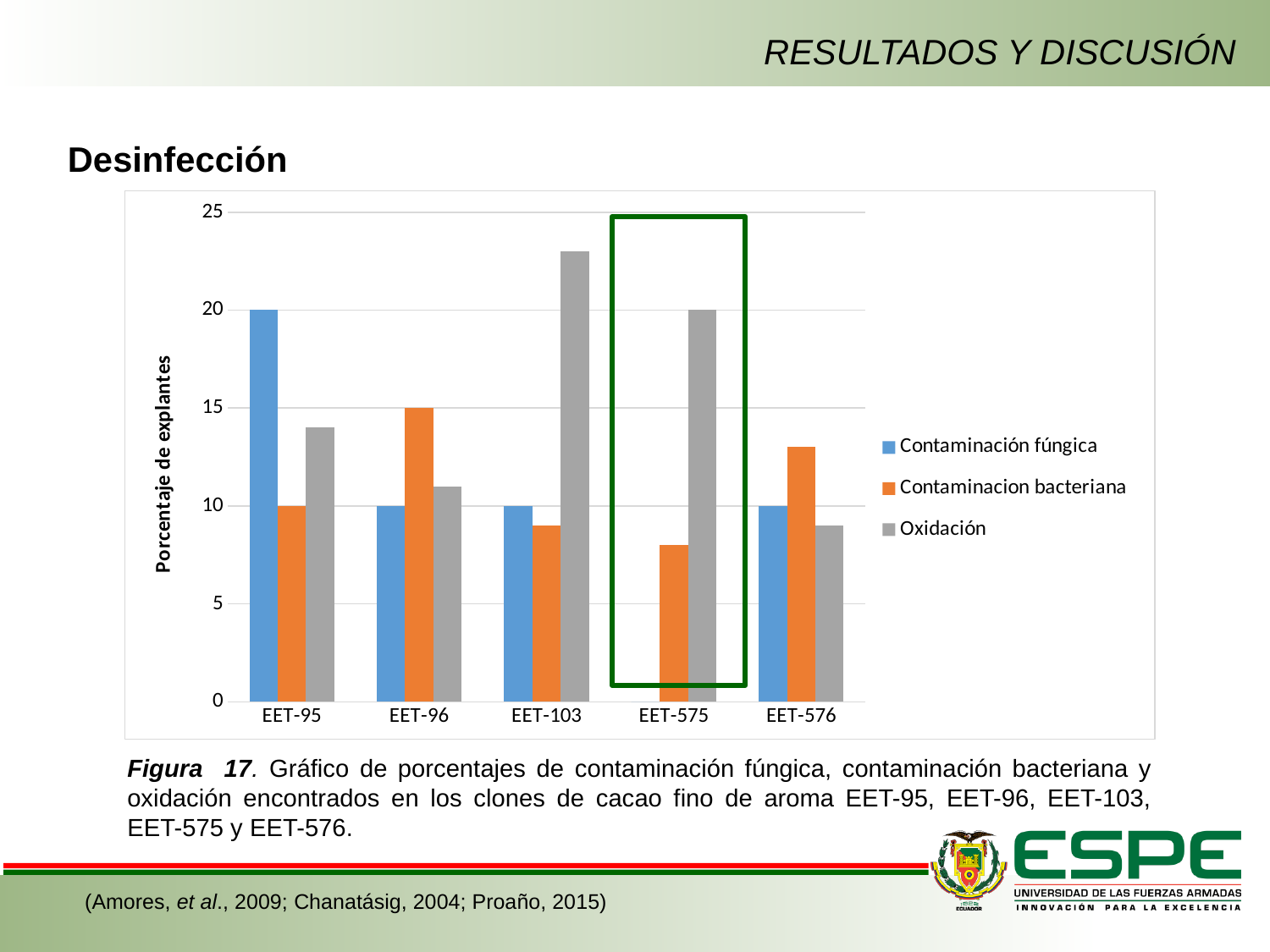
What is the value of Contaminación fúngica for EET-95? 20 What is the value of Contaminación fúngica for EET-103? 10 Which clone has the highest Oxidación value? EET-103 What is the label of the vertical axis? Porcentaje de explantes How many series does the legend list? 3 What is the difference between Contaminación fúngica and Contaminacion bacteriana for EET-95? 10 Which clone has the highest Contaminación fúngica value? EET-95 Is the Oxidación value for EET-103 greater or less than 20? greater What is the value of Contaminacion bacteriana for EET-96? 15 What is the value of Oxidación for EET-575? 20 What type of chart is shown on the slide? bar chart How many clone categories are shown on the x axis? 5